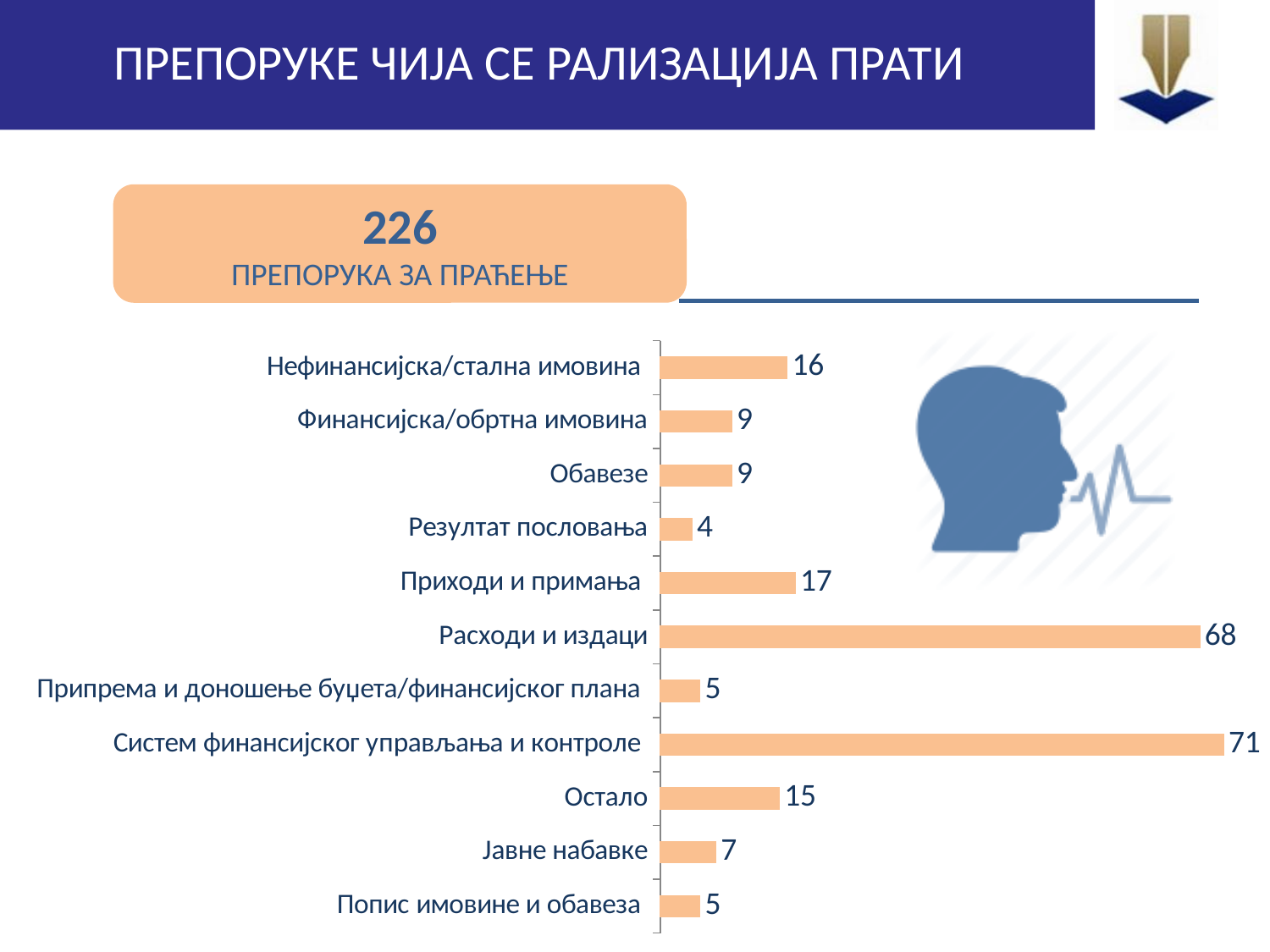
Which category has the highest value? Систем финансијског управљања и контроле What is the value for Расходи и издаци? 68 What kind of chart is shown on the slide? Bar chart How many categories are shown in the chart? 11 What is the value for Јавне набавке? 7 Which is larger, the value for Остало or the value for Финансијска/обртна имовина? Остало What is the difference between the values for Приходи и примања and Остало? 2 Which category has the lowest value? Резултат пословања What is the difference between the values for Систем финансијског управљања и контроле and Расходи и издаци? 3 What total number of recommendations for monitoring is shown in the box above the chart? 226 What is the value for Нефинансијска/стална имовина? 16 Which is larger, the value for Нефинансијска/стална имовина or the value for Приходи и примања? Приходи и примања